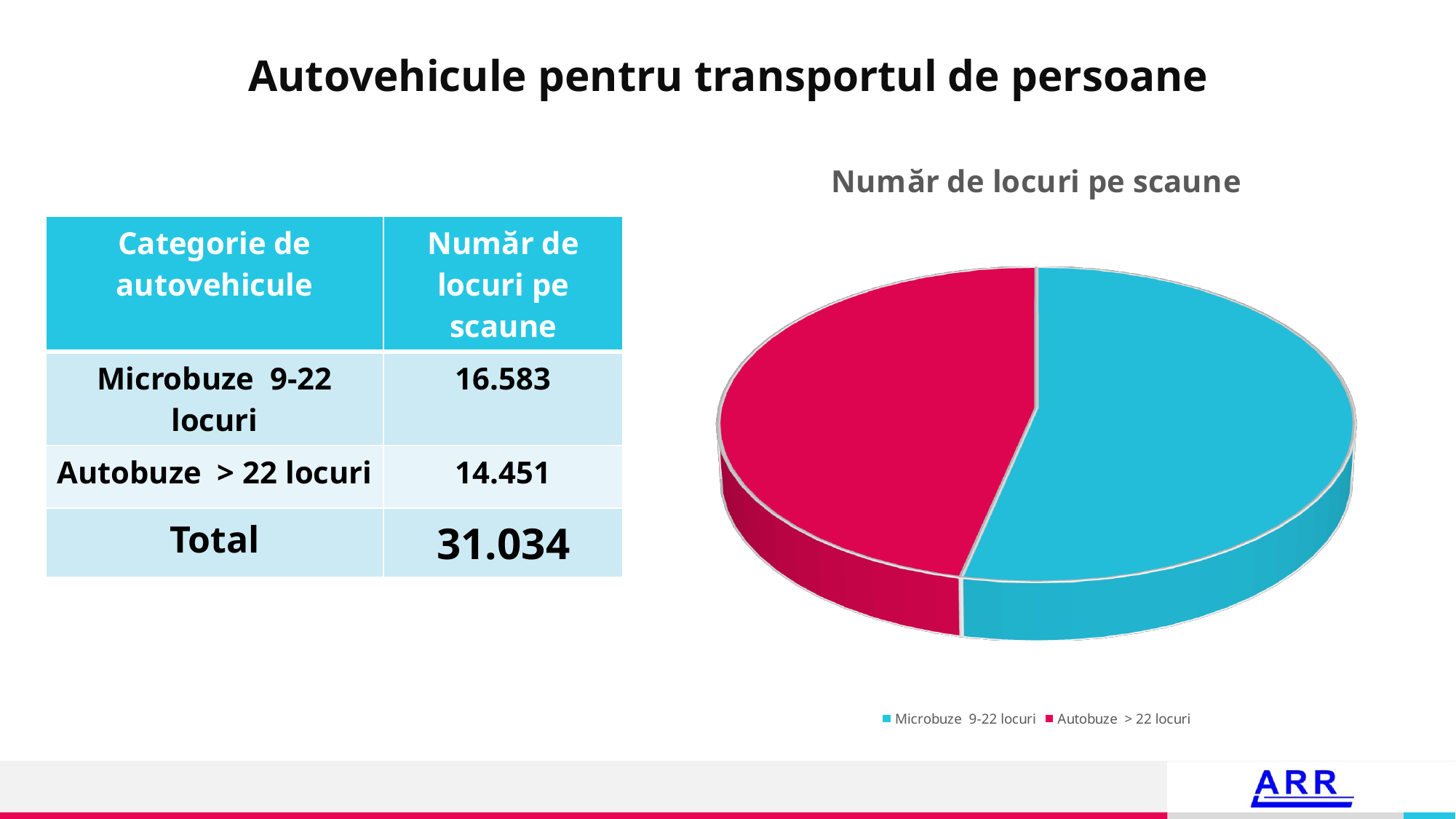
Which category has the larger slice in the pie chart? Microbuze 9-22 locuri What kind of chart is shown on the slide? pie chart Which category has the smaller slice in the pie chart? Autobuze > 22 locuri What is the total number of seats across both categories? 31.034 How many entries does the legend of the pie chart list? 2 What is the title of the pie chart? Număr de locuri pe scaune Is the value for Microbuze 9-22 locuri larger or smaller than the value for Autobuze > 22 locuri? larger What is the number of seats (Număr de locuri pe scaune) for Microbuze 9-22 locuri? 16.583 Which colour represents Autobuze > 22 locuri in the pie chart? red What is the number of seats (Număr de locuri pe scaune) for Autobuze > 22 locuri? 14.451 How many slices does the pie chart have? 2 What is the difference in number of seats between Microbuze 9-22 locuri and Autobuze > 22 locuri? 2.132